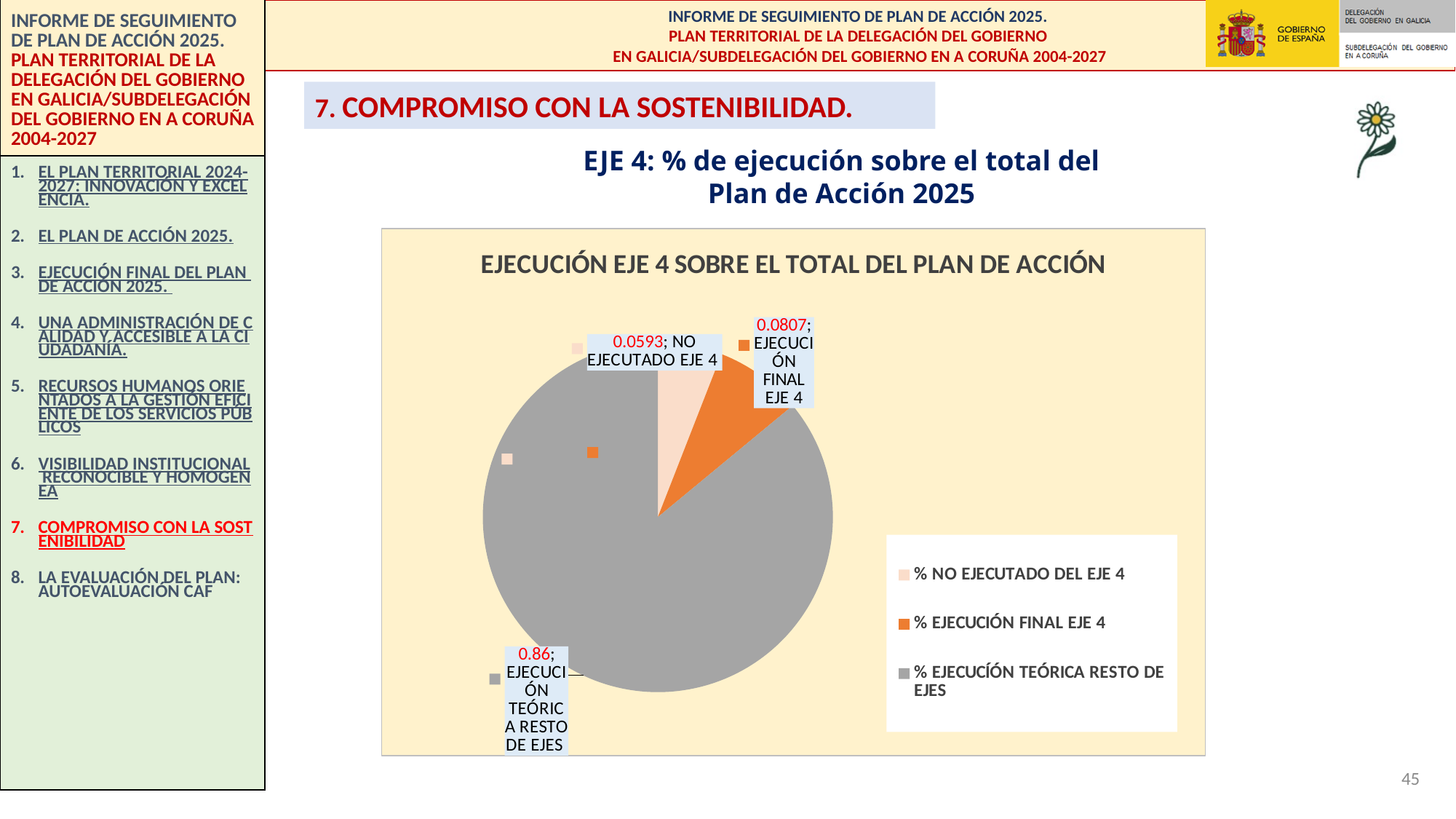
What is the value labelled for the EJECUCIÓN FINAL EJE 4 slice? 0.0807 Which slice of the pie chart is the largest? EJECUCIÓN TEÓRICA RESTO DE EJES Which is larger, the EJECUCIÓN FINAL EJE 4 slice or the NO EJECUTADO EJE 4 slice? EJECUCIÓN FINAL EJE 4 What is the value labelled for the EJECUCIÓN TEÓRICA RESTO DE EJES slice? 0.86 What is the title of the pie chart? EJECUCIÓN EJE 4 SOBRE EL TOTAL DEL PLAN DE ACCIÓN How many slices does the pie chart have? 3 How many entries does the legend of the pie chart list? 3 Which slice of the pie chart is the smallest? NO EJECUTADO EJE 4 What colour is the EJECUCIÓN FINAL EJE 4 slice in the pie chart? Orange What is the difference between the EJECUCIÓN FINAL EJE 4 value and the NO EJECUTADO EJE 4 value? 0.0214 What kind of chart is shown on the slide? Pie chart What is the value labelled for the NO EJECUTADO EJE 4 slice? 0.0593